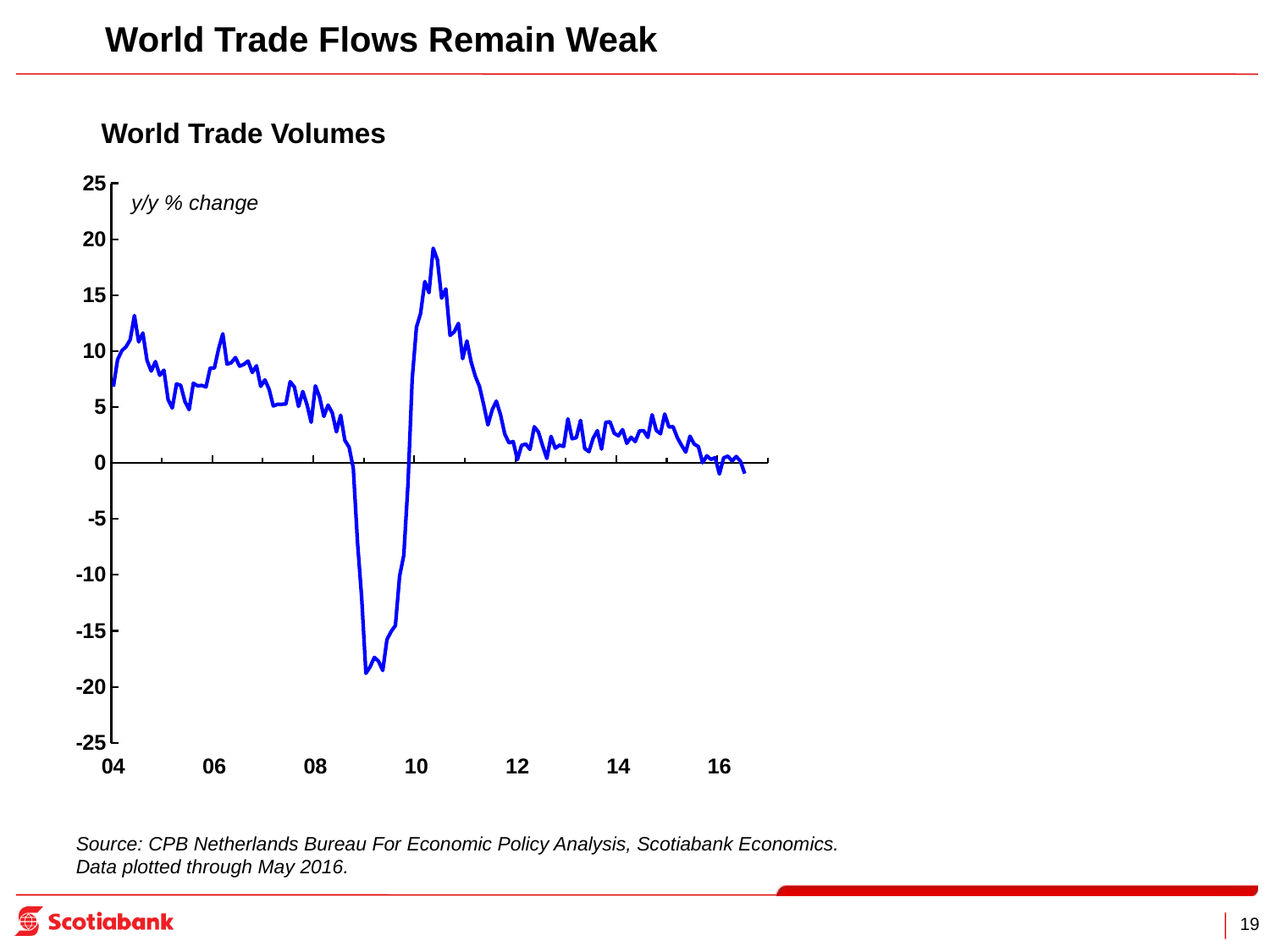
Around which year on the x axis does the line reach its highest point? 2010 Is the lowest value of the line, reached around 2009, greater or less than -15? less How many lines are plotted on the chart? 1 What kind of chart is shown on the slide? line chart Are the values during 2013 greater or less than 5? less Is the highest value of the line, reached around 2010, greater or less than 15? greater Does the line rise or fall between its 2010 peak and 2012? fall What is the highest value shown on the y axis? 25 Around which year on the x axis does the line reach its lowest point? 2009 What unit is the chart's y axis measured in, as labelled inside the plot? y/y % change What is the title of the chart? World Trade Volumes